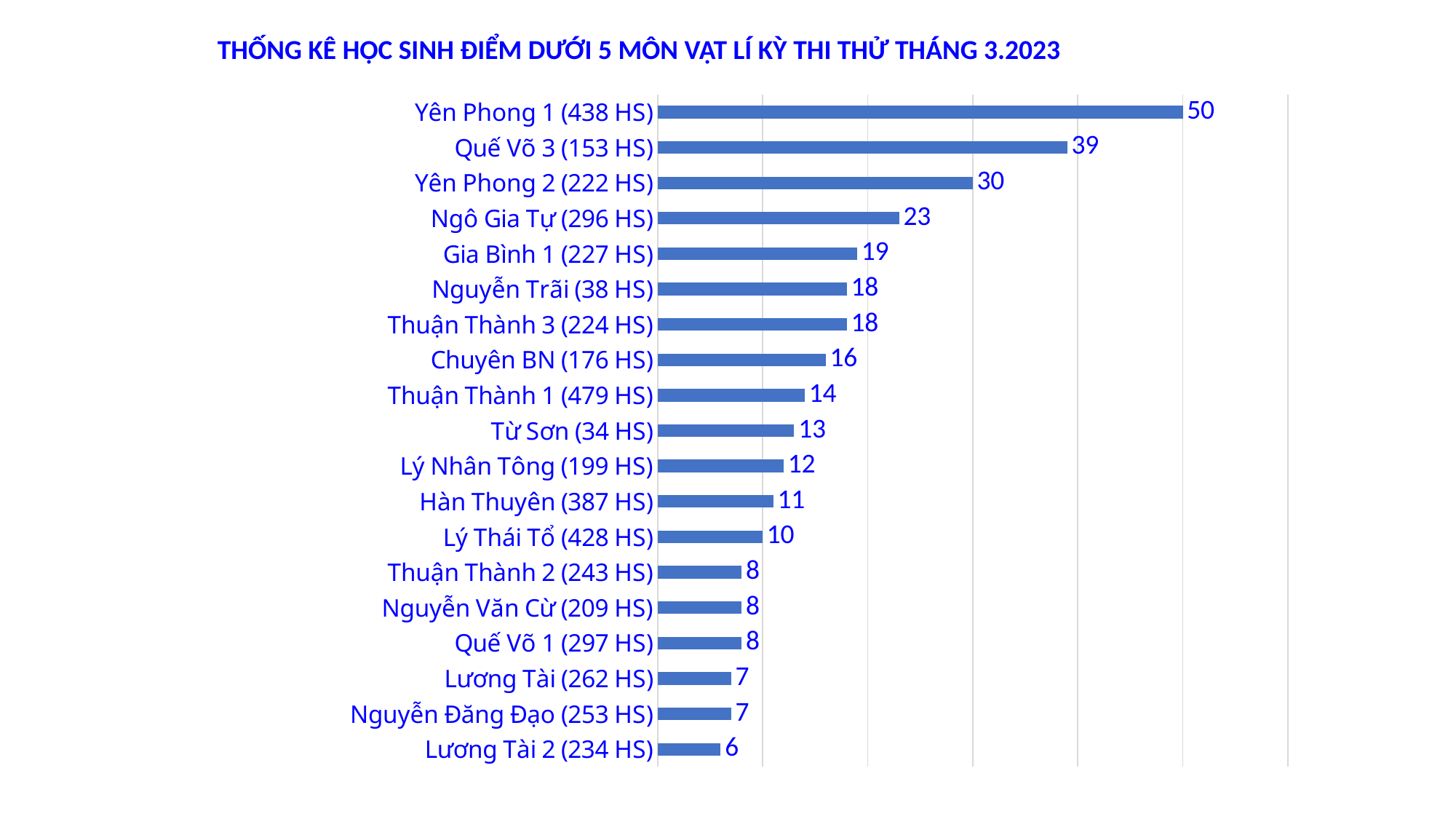
What is the difference between the values for Yên Phong 1 (438 HS) and Lương Tài 2 (234 HS)? 44 Which category has the lowest value? Lương Tài 2 (234 HS) What kind of chart is shown on the slide? Bar chart What is the title of the chart? THỐNG KÊ HỌC SINH ĐIỂM DƯỚI 5 MÔN VẬT LÍ KỲ THI THỬ THÁNG 3.2023 How many categories are shown in the chart? 19 Which is larger, the value for Ngô Gia Tự (296 HS) or the value for Gia Bình 1 (227 HS)? Ngô Gia Tự (296 HS) What is the value for Lý Thái Tổ (428 HS)? 10 What is the difference between the values for Quế Võ 3 (153 HS) and Yên Phong 2 (222 HS)? 9 What is the value for Chuyên BN (176 HS)? 16 What is the value for Yên Phong 1 (438 HS)? 50 Which category has the highest value? Yên Phong 1 (438 HS) What is the value for Từ Sơn (34 HS)? 13